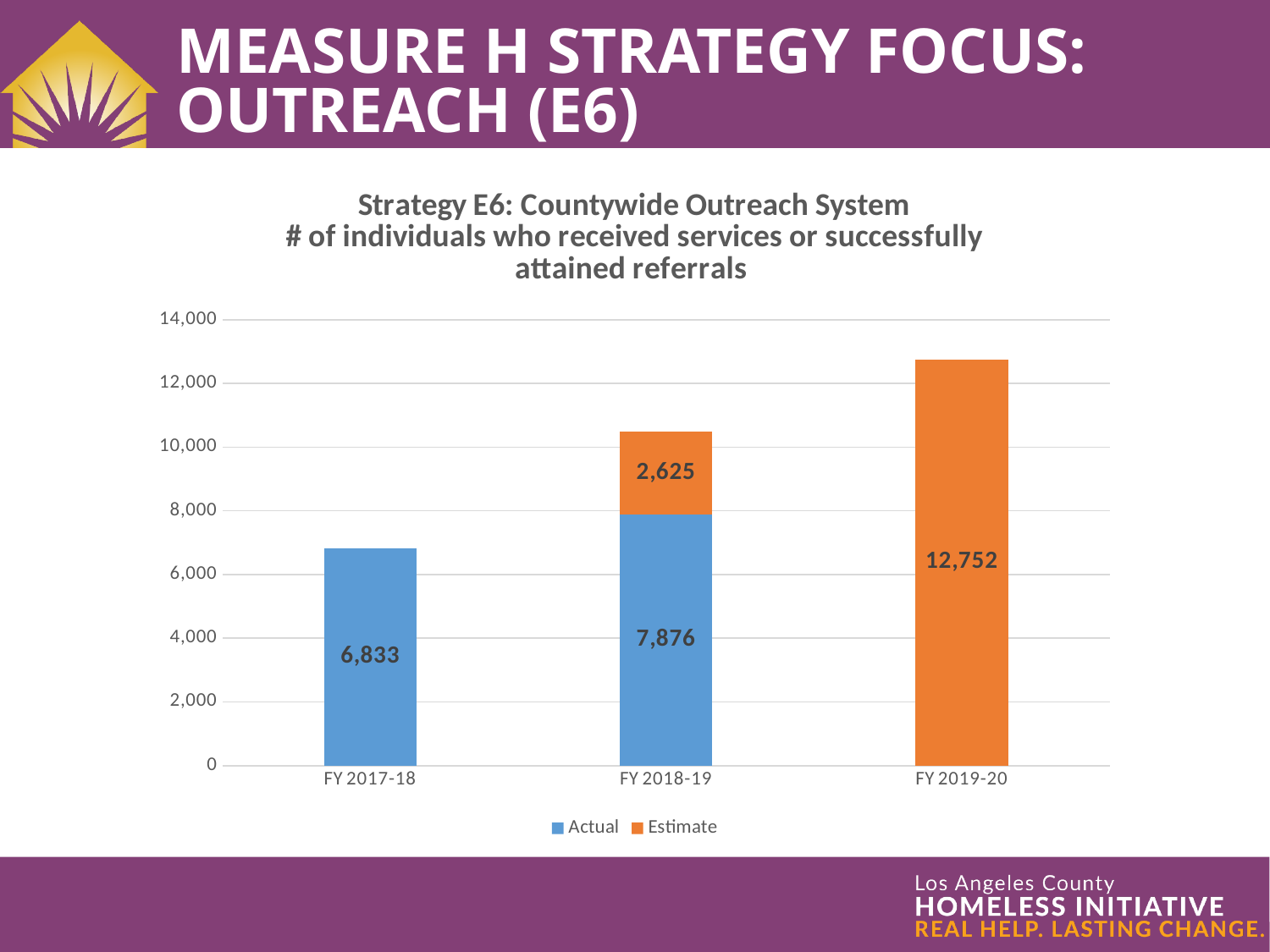
What is the Actual value for FY 2017-18? 6,833 What is the Estimate value for FY 2018-19? 2,625 What is the total of the stacked bar for FY 2018-19? 10,501 Is the Actual value for FY 2018-19 larger than the Actual value for FY 2017-18? Yes Which fiscal year has the tallest bar overall? FY 2019-20 What kind of chart is shown on the slide? Stacked bar chart Which fiscal year has the shortest bar overall? FY 2017-18 How many fiscal years are shown on the x axis? 3 What is the Actual value for FY 2018-19? 7,876 What is the difference between the Actual values for FY 2018-19 and FY 2017-18? 1,043 What is the Estimate value for FY 2019-20? 12,752 How many series does the legend list? 2